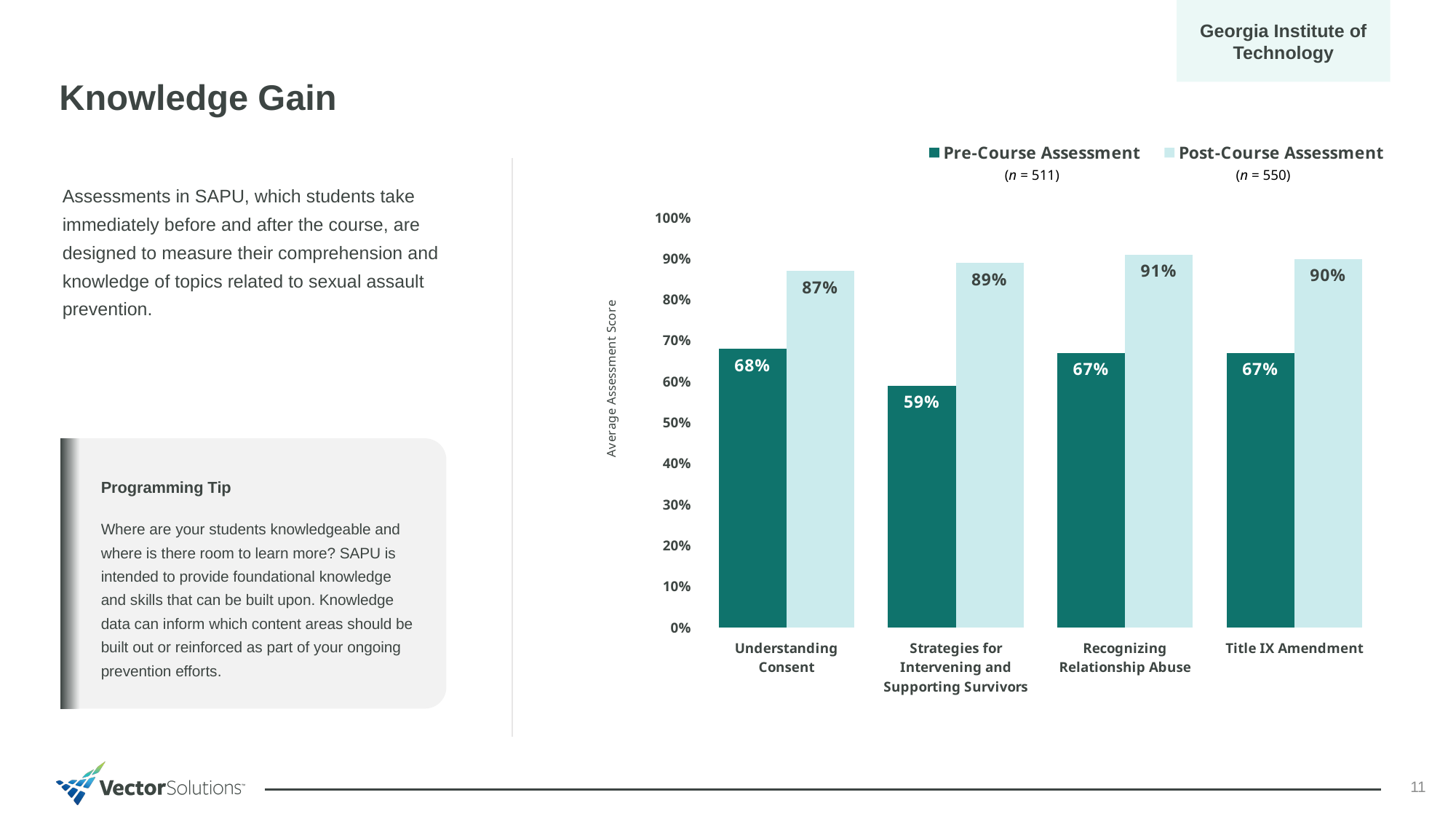
What is the Pre-Course Assessment value for Strategies for Intervening and Supporting Survivors? 59% What is the label of the chart's vertical axis? Average Assessment Score What is the difference between the Post-Course and Pre-Course Assessment values for Strategies for Intervening and Supporting Survivors? 30% Which is larger: the Post-Course Assessment value for Understanding Consent or for Title IX Amendment? Title IX Amendment How many series does the chart legend list? 2 What is the Post-Course Assessment value for Recognizing Relationship Abuse? 91% What is the difference between the Post-Course and Pre-Course Assessment values for Title IX Amendment? 23% What is the Pre-Course Assessment value for Understanding Consent? 68% Which category has the highest Post-Course Assessment value? Recognizing Relationship Abuse Which category has the lowest Pre-Course Assessment value? Strategies for Intervening and Supporting Survivors What kind of chart is shown on the slide? Bar chart How many categories are shown on the x axis of the chart? 4